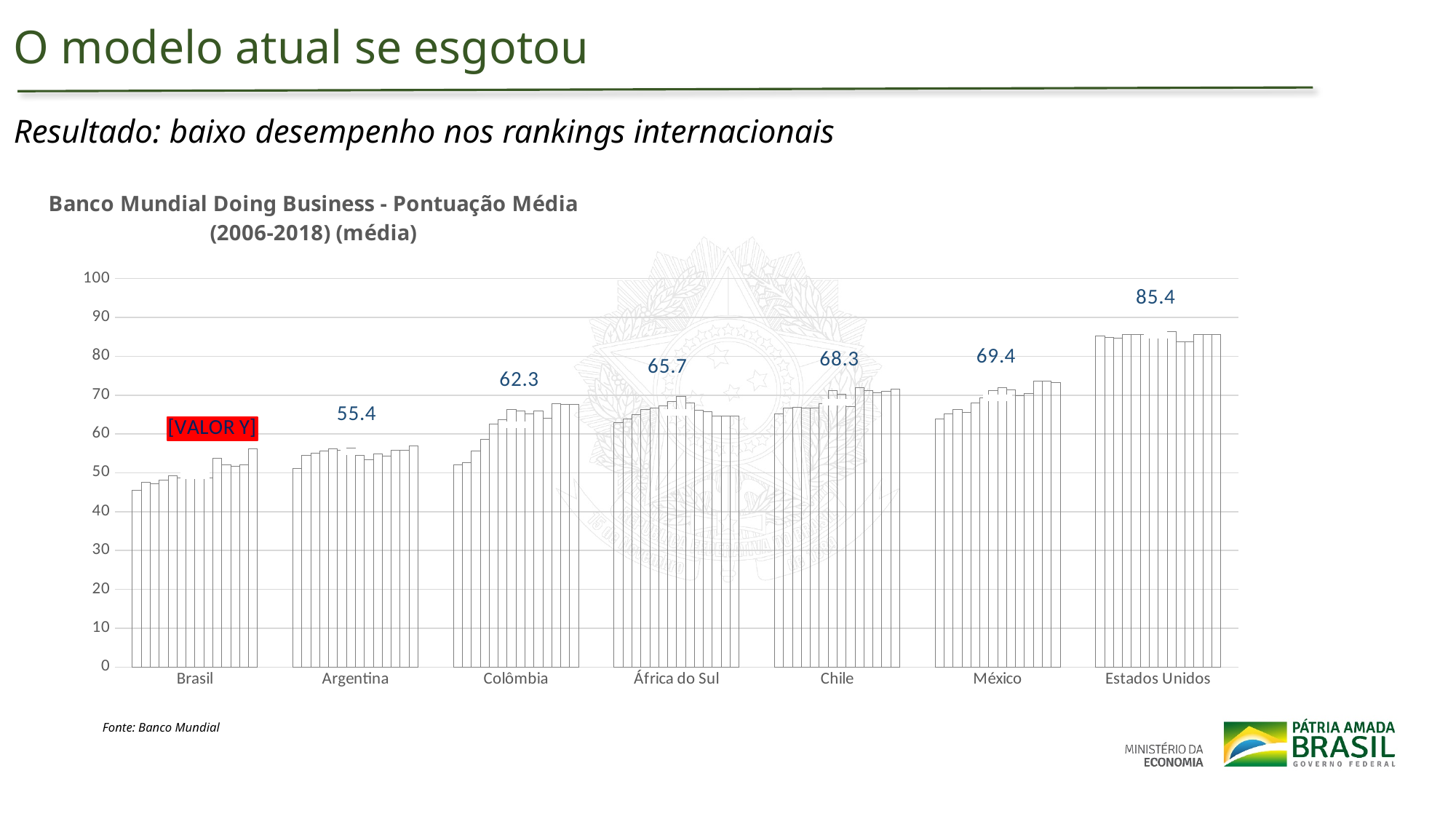
What is the difference between the labelled average scores of Colômbia and Argentina? 6.9 What is the difference between the labelled average scores of Estados Unidos and México? 16.0 What is the labelled average score for Argentina? 55.4 What kind of chart is shown on the slide? bar chart Are the bars for Brasil greater or less than 60? less What is the labelled average score for México? 69.4 Which country has the highest average score in the chart? Estados Unidos How many countries are shown on the x axis of the chart? 7 What is the labelled average score for Estados Unidos? 85.4 What is the labelled average score for Chile? 68.3 Which country has the lowest bars in the chart? Brasil Which has a higher labelled average score, Chile or África do Sul? Chile